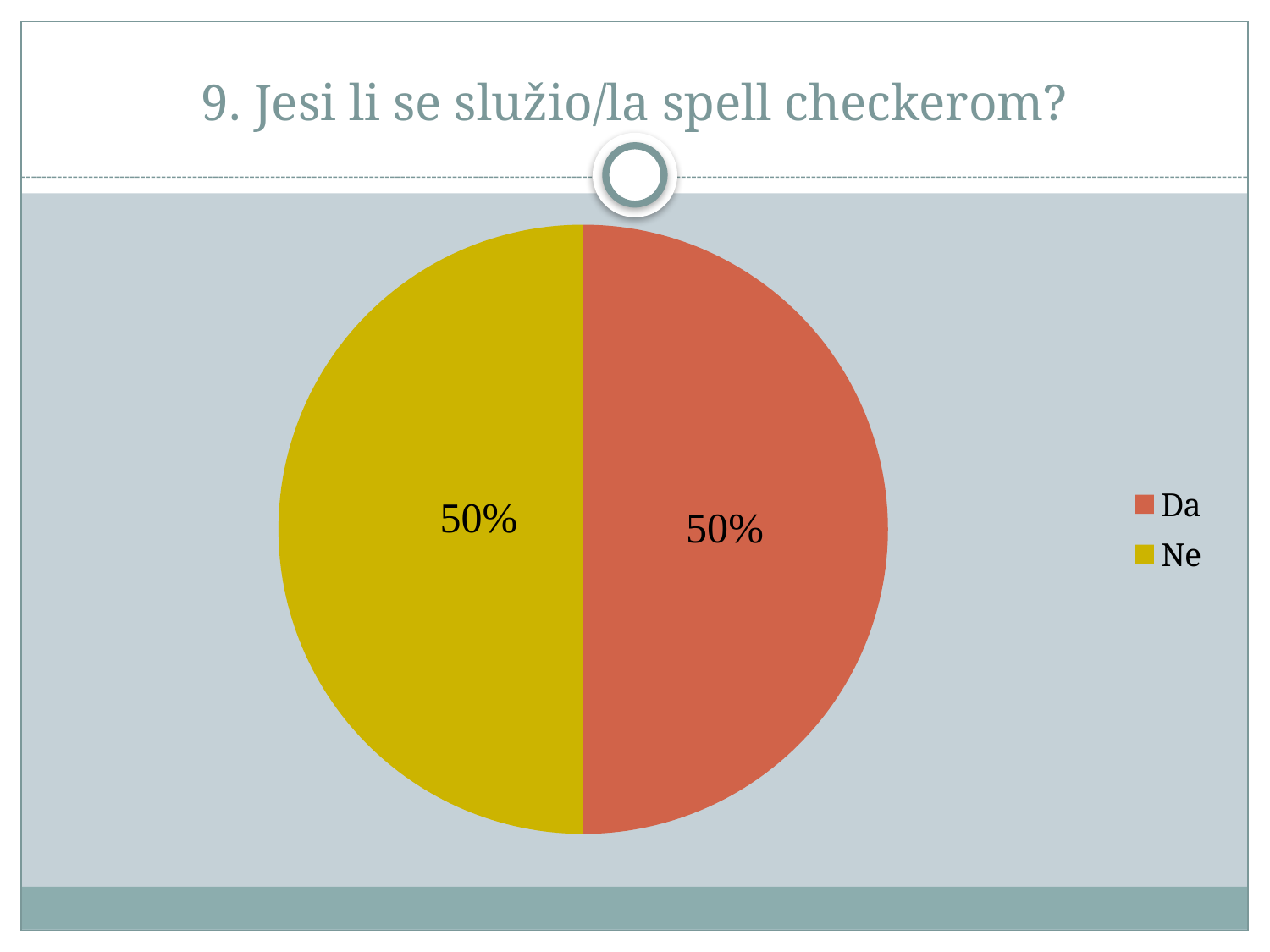
What share of the pie does the "Da" slice represent? 50% What is the title of the slide containing the pie chart? 9. Jesi li se služio/la spell checkerom? How many slices does the pie chart have? 2 Is the share for "Ne" greater or less than 75%? less What share of the pie does the "Ne" slice represent? 50% What is the difference between the "Da" and "Ne" shares? 0% Which colour represents "Ne" in the pie chart? yellow How many entries does the legend list? 2 Is the share for "Da" greater or less than 25%? greater What kind of chart is shown on the slide? pie chart